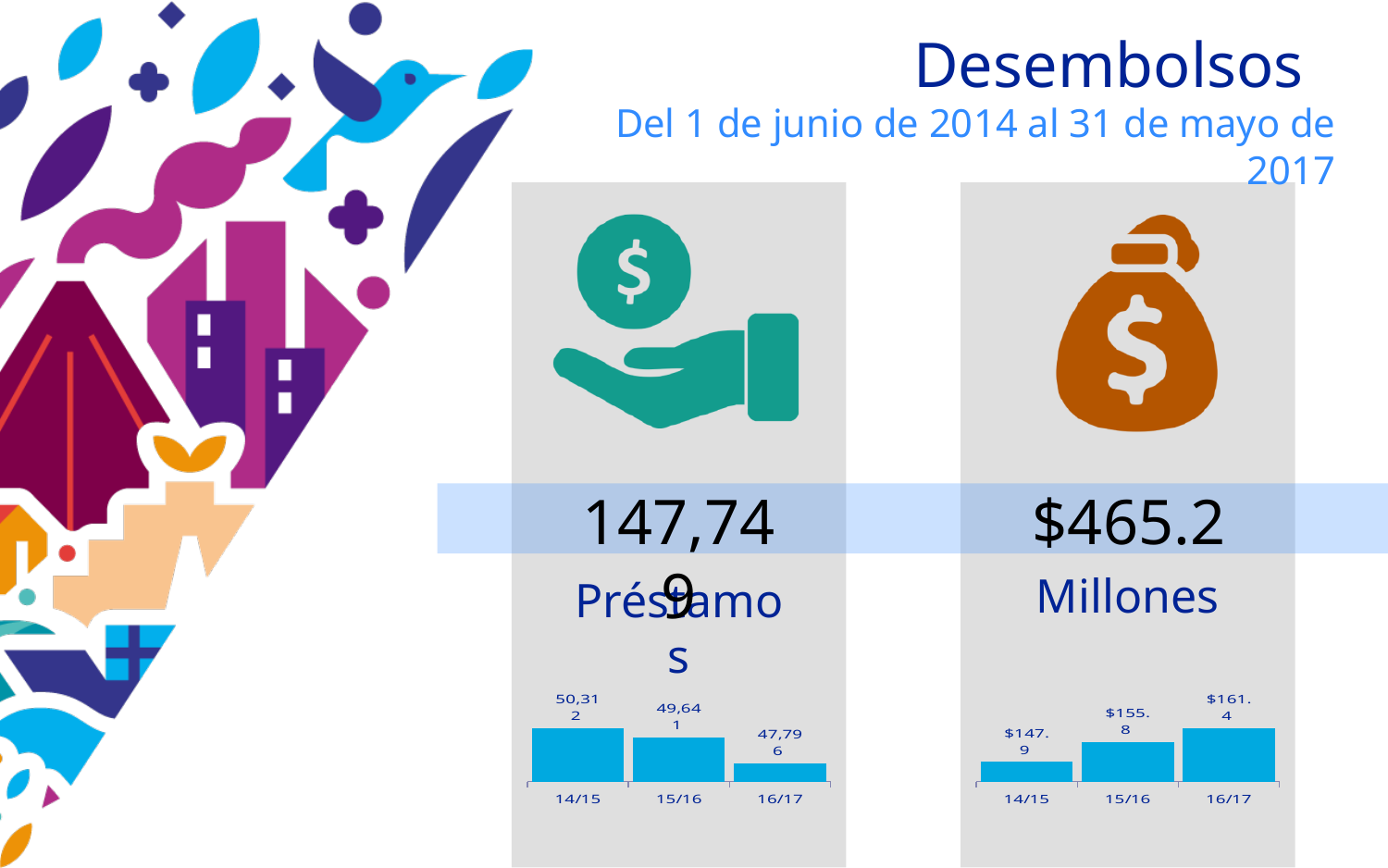
In the right chart (under Millones), what is the value for 16/17? $161.4 In the left chart (under Préstamos), what is the value for 16/17? 47,796 What type of chart is the right chart (under Millones)? Bar chart In the right chart (under Millones), which period has the lowest value? 14/15 In the left chart (under Préstamos), what is the difference between the 14/15 and 16/17 values? 2,516 In the left chart (under Préstamos), what is the value for 14/15? 50,312 In the left chart (under Préstamos), do the values rise or fall from 14/15 to 16/17? Fall In the right chart (under Millones), what is the value for 15/16? $155.8 In the right chart (under Millones), what is the difference between the 16/17 and 14/15 values? $13.5 How many bars are in the left chart (under Préstamos)? 3 In the left chart (under Préstamos), which period has the highest value? 14/15 In the right chart (under Millones), which is larger, the value for 15/16 or 16/17? 16/17